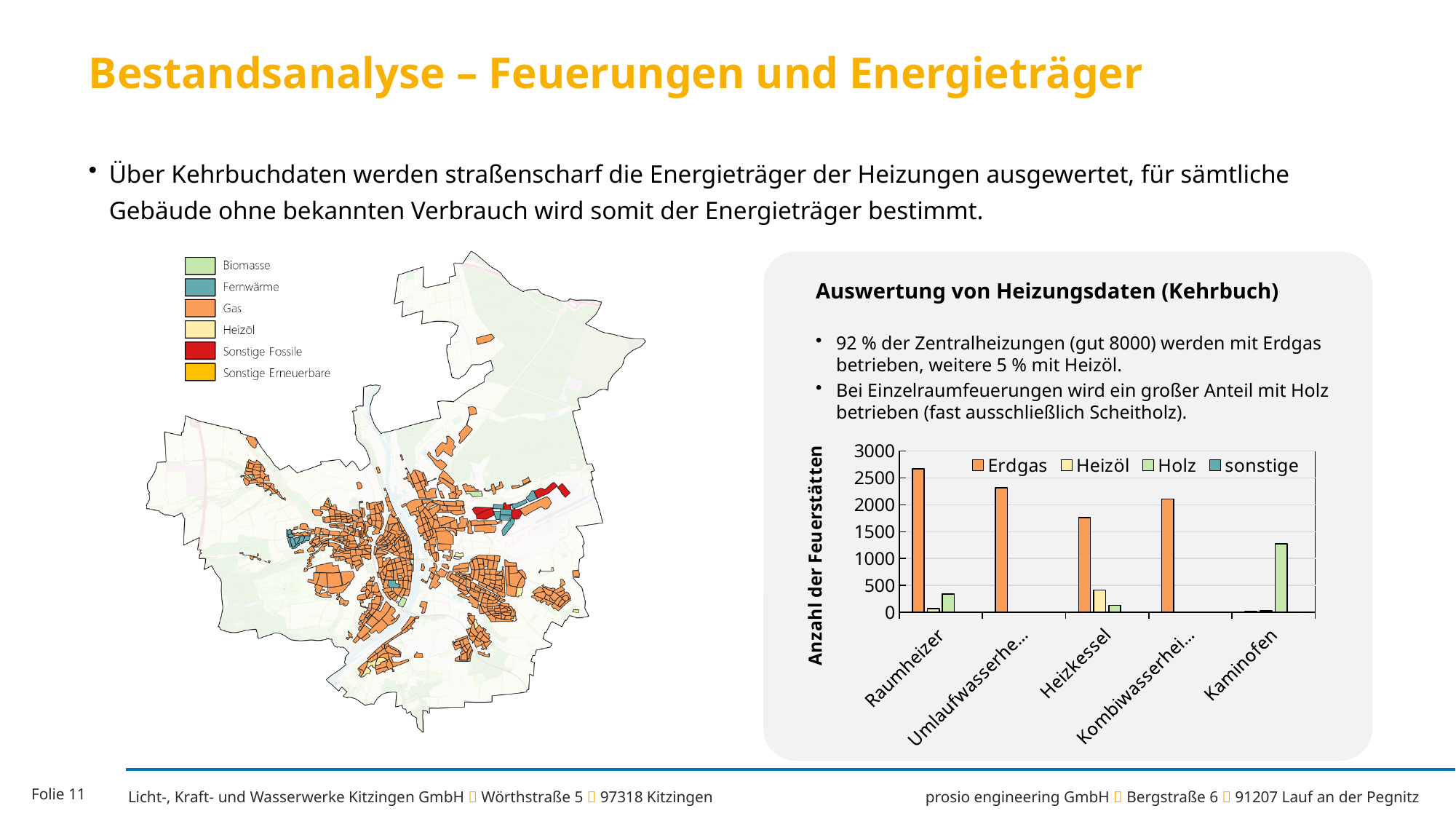
Is the Holz value for Kaminofen greater or less than 1000? greater Which is larger in the bar chart: the Heizöl value for Heizkessel or the Heizöl value for Raumheizer? Heizkessel Is the Erdgas value for Heizkessel greater or less than 2000? less How many series does the legend of the bar chart list? 4 Is the Erdgas value for Raumheizer greater or less than 2500? greater Which category has the highest Erdgas value in the bar chart? Raumheizer What kind of chart is shown on the right side of the slide? bar chart Which is larger in the bar chart: the Erdgas value for Umlaufwasserheizer or the Erdgas value for Heizkessel? Umlaufwasserheizer Which category has the highest Holz value in the bar chart? Kaminofen How many categories are shown on the x axis of the bar chart? 5 What is the label of the y axis of the bar chart? Anzahl der Feuerstätten